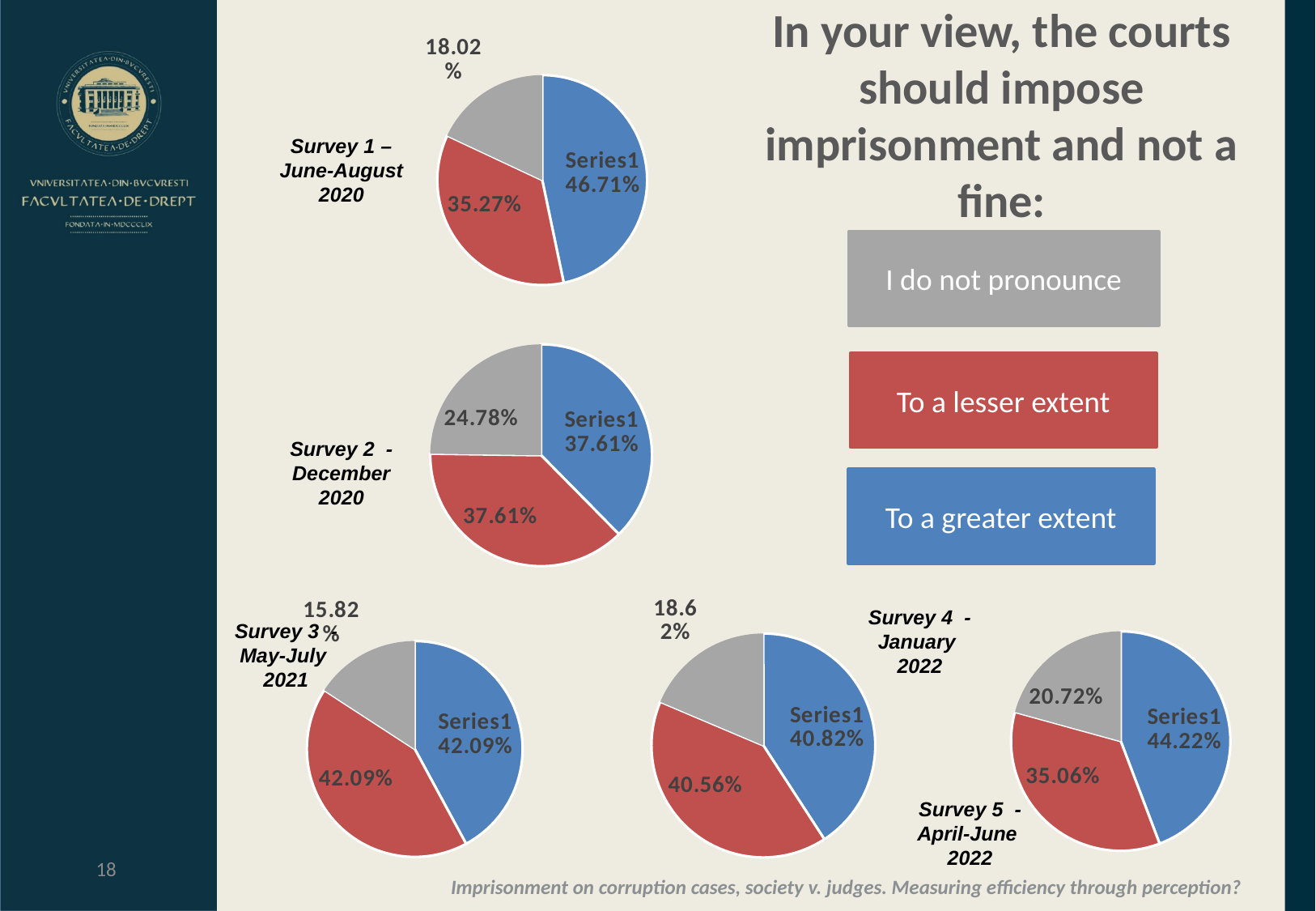
In the Survey 2 - December 2020 pie chart, what is the value of the 'I do not pronounce' (grey) slice? 24.78% In the Survey 5 - April-June 2022 pie chart, which response has the largest share? To a greater extent In the Survey 5 - April-June 2022 pie chart, which is larger: the 'To a greater extent' slice or the 'To a lesser extent' slice? To a greater extent In the Survey 1 – June-August 2020 pie chart, what share of respondents answered 'To a greater extent' (blue slice)? 46.71% In the Survey 5 - April-June 2022 pie chart, what is the value of the red 'To a lesser extent' slice? 35.06% In the Survey 1 – June-August 2020 pie chart, what is the difference between the 'To a greater extent' and 'To a lesser extent' shares? 11.44% What type of chart is used to show the survey results on this slide? Pie chart In the Survey 4 - January 2022 pie chart, what is the value of the blue 'To a greater extent' slice? 40.82% In the Survey 1 – June-August 2020 pie chart, what is the value of the grey 'I do not pronounce' slice? 18.02% How many pie charts are shown on the slide? 5 In the Survey 1 – June-August 2020 pie chart, which response has the smallest share? I do not pronounce In the Survey 3 - May-July 2021 pie chart, what is the value of the red 'To a lesser extent' slice? 42.09%